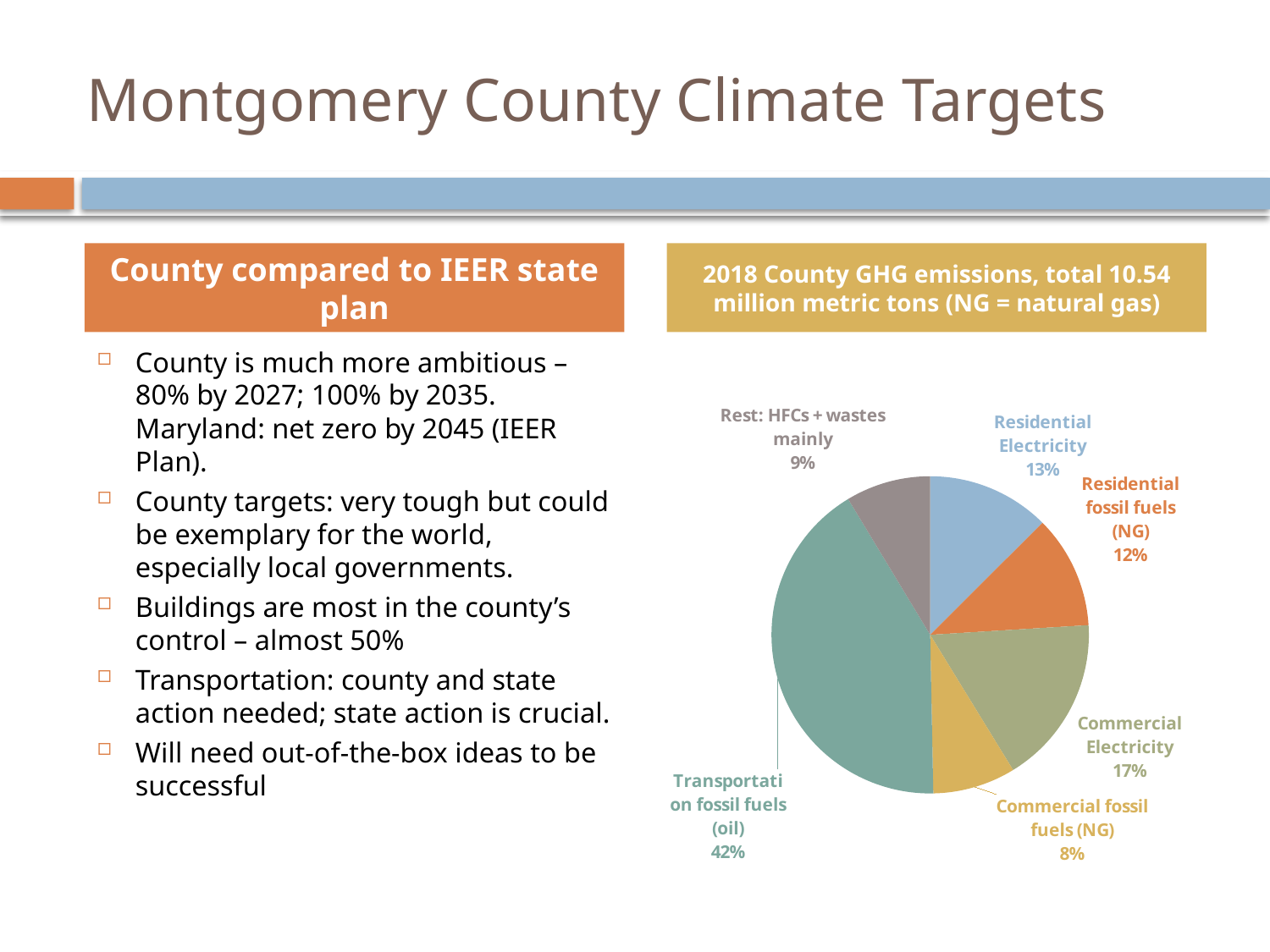
Which is larger: the Residential Electricity share or the Residential fossil fuels (NG) share? Residential Electricity What percentage of the pie is Commercial Electricity? 17% Which category accounts for the largest share of 2018 County GHG emissions? Transportation on fossil fuels (oil) How many slices does the pie chart have? 6 What share of emissions is attributed to Residential fossil fuels (NG)? 12% What is the combined share of Residential Electricity and Commercial Electricity? 30% How many percentage points larger is the Commercial Electricity share than the Commercial fossil fuels (NG) share? 9 Which category accounts for the smallest share of 2018 County GHG emissions? Commercial fossil fuels (NG) What type of chart is shown on the slide? Pie chart According to the chart title, what is the total of 2018 County GHG emissions? 10.54 million metric tons What share of 2018 County GHG emissions comes from Transportation on fossil fuels (oil)? 42% What percentage does the 'Rest: HFCs + wastes mainly' slice represent? 9%